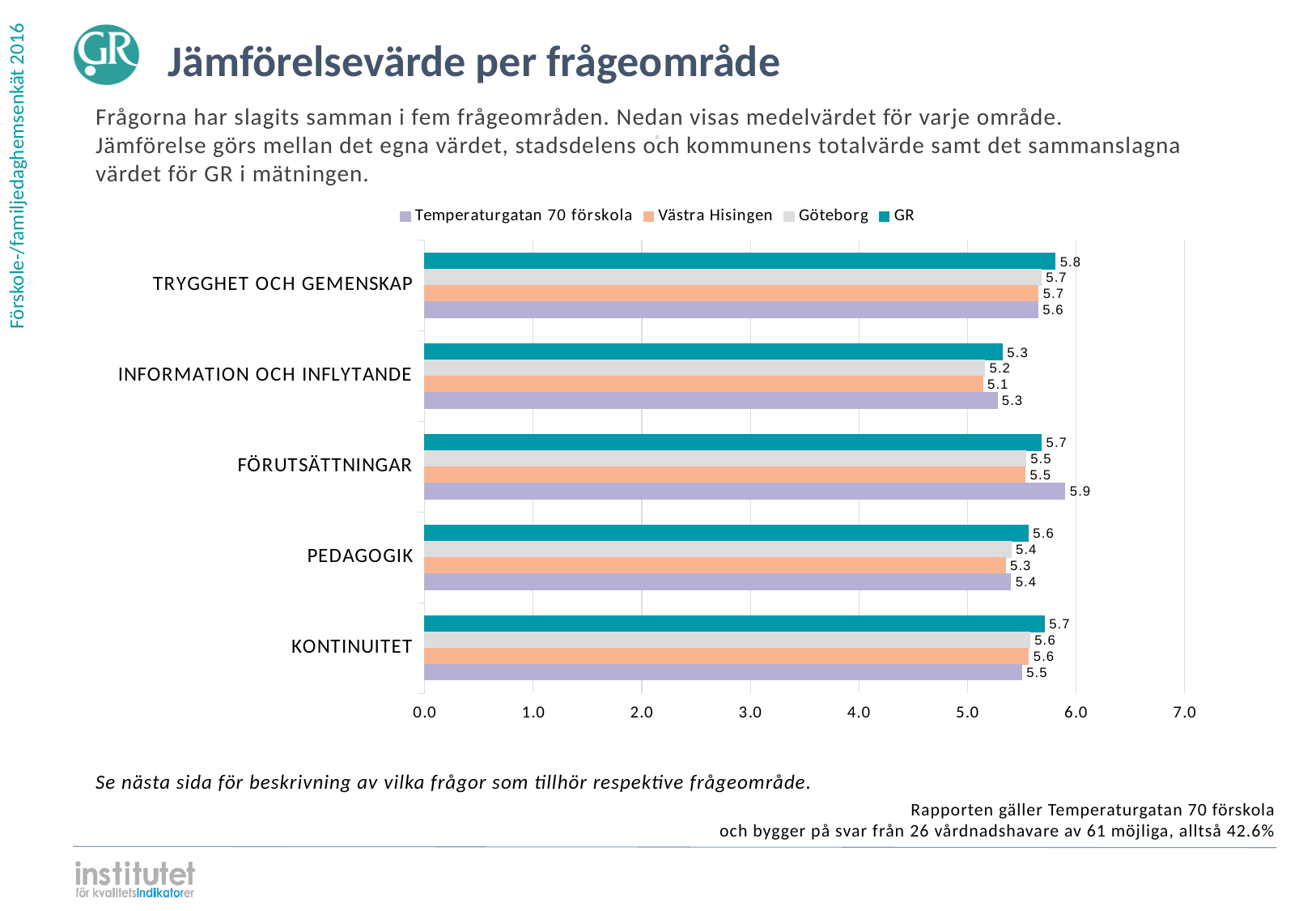
Which category has the highest value for Temperaturgatan 70 förskola? FÖRUTSÄTTNINGAR What is the value for Temperaturgatan 70 förskola in FÖRUTSÄTTNINGAR? 5.9 What is the value for Göteborg in PEDAGOGIK? 5.4 What is the value for Västra Hisingen in INFORMATION OCH INFLYTANDE? 5.1 What kind of chart is shown on the slide? Bar chart What is the difference between the GR value and the Temperaturgatan 70 förskola value in KONTINUITET? 0.2 How many series does the legend list? 4 Which category has the lowest value for Temperaturgatan 70 förskola? INFORMATION OCH INFLYTANDE What is the value for GR in TRYGGHET OCH GEMENSKAP? 5.8 In FÖRUTSÄTTNINGAR, which is larger: the value for Temperaturgatan 70 förskola or the value for GR? Temperaturgatan 70 förskola How many categories are shown on the chart? 5 What is the title of the slide? Jämförelsevärde per frågeområde